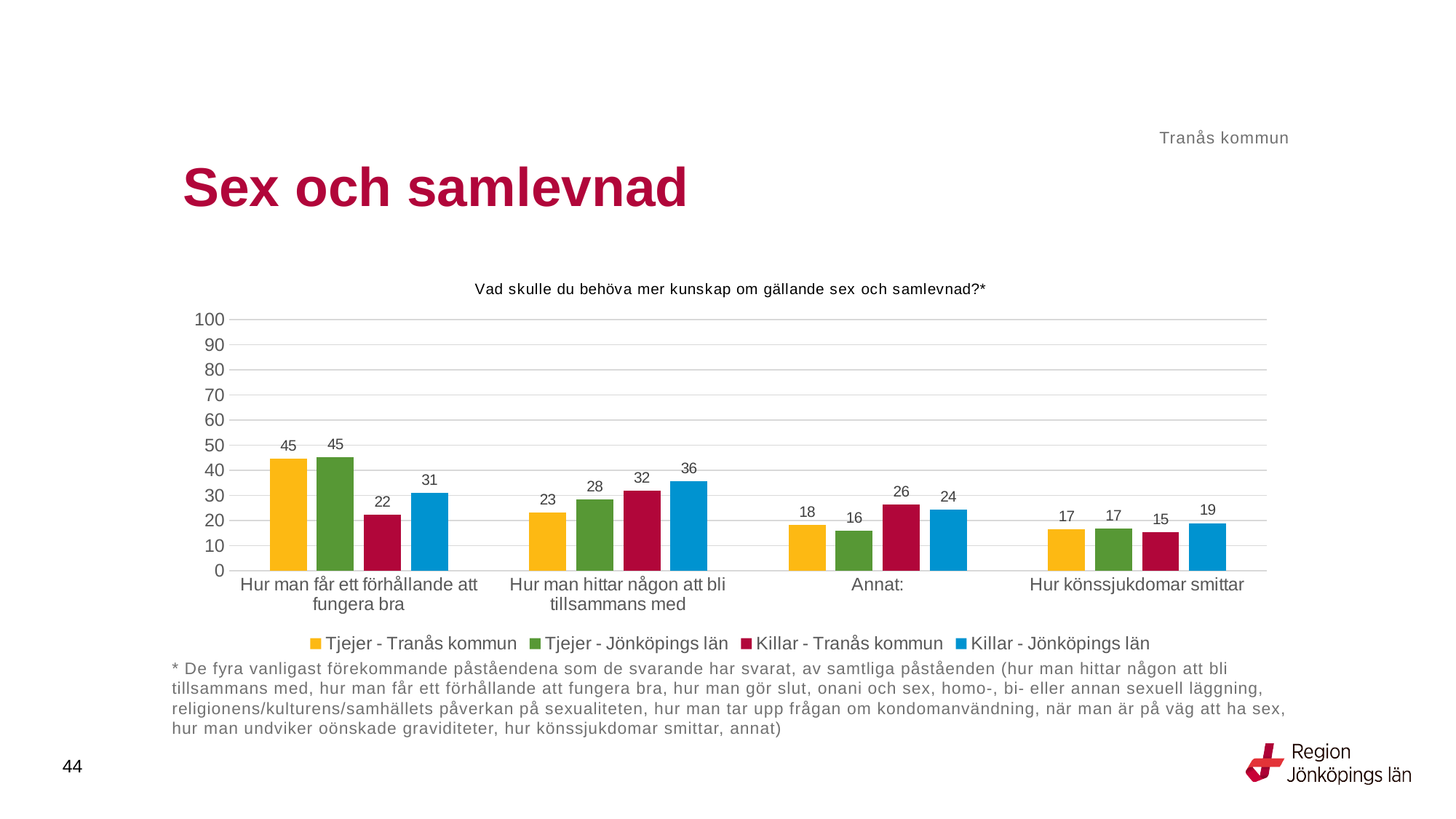
What is the value for Tjejer - Tranås kommun in the category 'Hur man får ett förhållande att fungera bra'? 45 Which is larger in the category 'Annat:': Tjejer - Tranås kommun or Killar - Jönköpings län? Killar - Jönköpings län Is the value for Killar - Jönköpings län in 'Hur man får ett förhållande att fungera bra' greater or less than 40? less What is the difference between Tjejer - Tranås kommun and Killar - Tranås kommun in the category 'Hur man får ett förhållande att fungera bra'? 23 Which series has the highest value in the category 'Hur man hittar någon att bli tillsammans med'? Killar - Jönköpings län Which series has the lowest value in the category 'Hur man får ett förhållande att fungera bra'? Killar - Tranås kommun What is the value for Killar - Jönköpings län in the category 'Hur man hittar någon att bli tillsammans med'? 36 How many categories are shown on the x axis of the chart? 4 What is the value for Tjejer - Jönköpings län in the category 'Hur könssjukdomar smittar'? 17 How many series does the legend list? 4 What is the value for Killar - Tranås kommun in the category 'Annat:'? 26 What kind of chart is shown on the slide? Bar chart